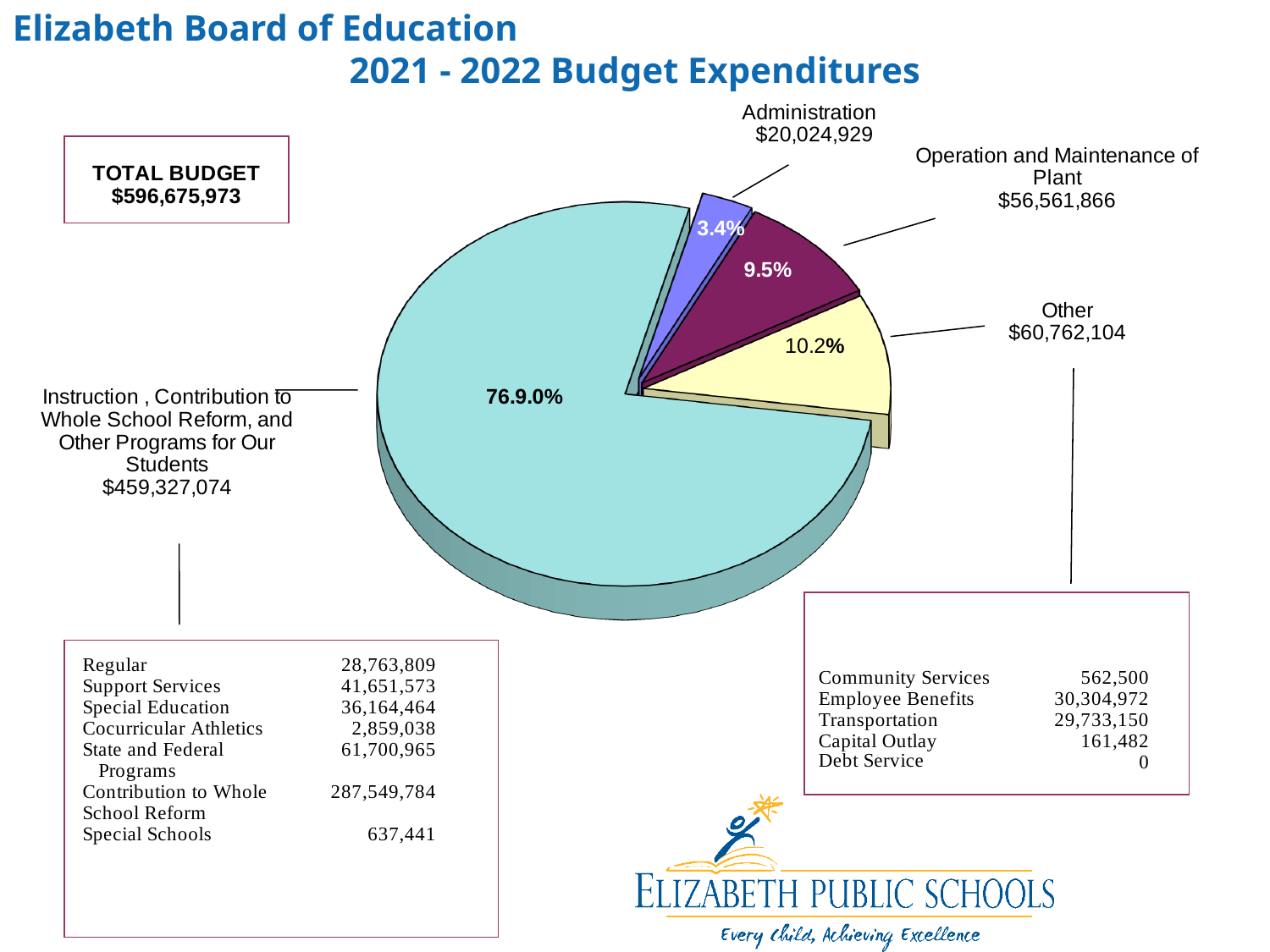
What share of the pie does Other represent? 10.2% What is the dollar value shown for Operation and Maintenance of Plant? $56,561,866 What share of the pie does Operation and Maintenance of Plant represent? 9.5% Which category has the largest slice of the pie? Instruction, Contribution to Whole School Reform, and Other Programs for Our Students What is the difference in dollars between Other and Operation and Maintenance of Plant? $4,200,238 What is the dollar value shown for Administration? $20,024,929 What is the dollar value shown for Instruction, Contribution to Whole School Reform, and Other Programs for Our Students? $459,327,074 What is the dollar value shown for Other? $60,762,104 What kind of chart is shown on the slide? pie chart Which category has the smallest slice of the pie? Administration What share of the pie does Administration represent? 3.4% How many slices does the pie chart have? 4